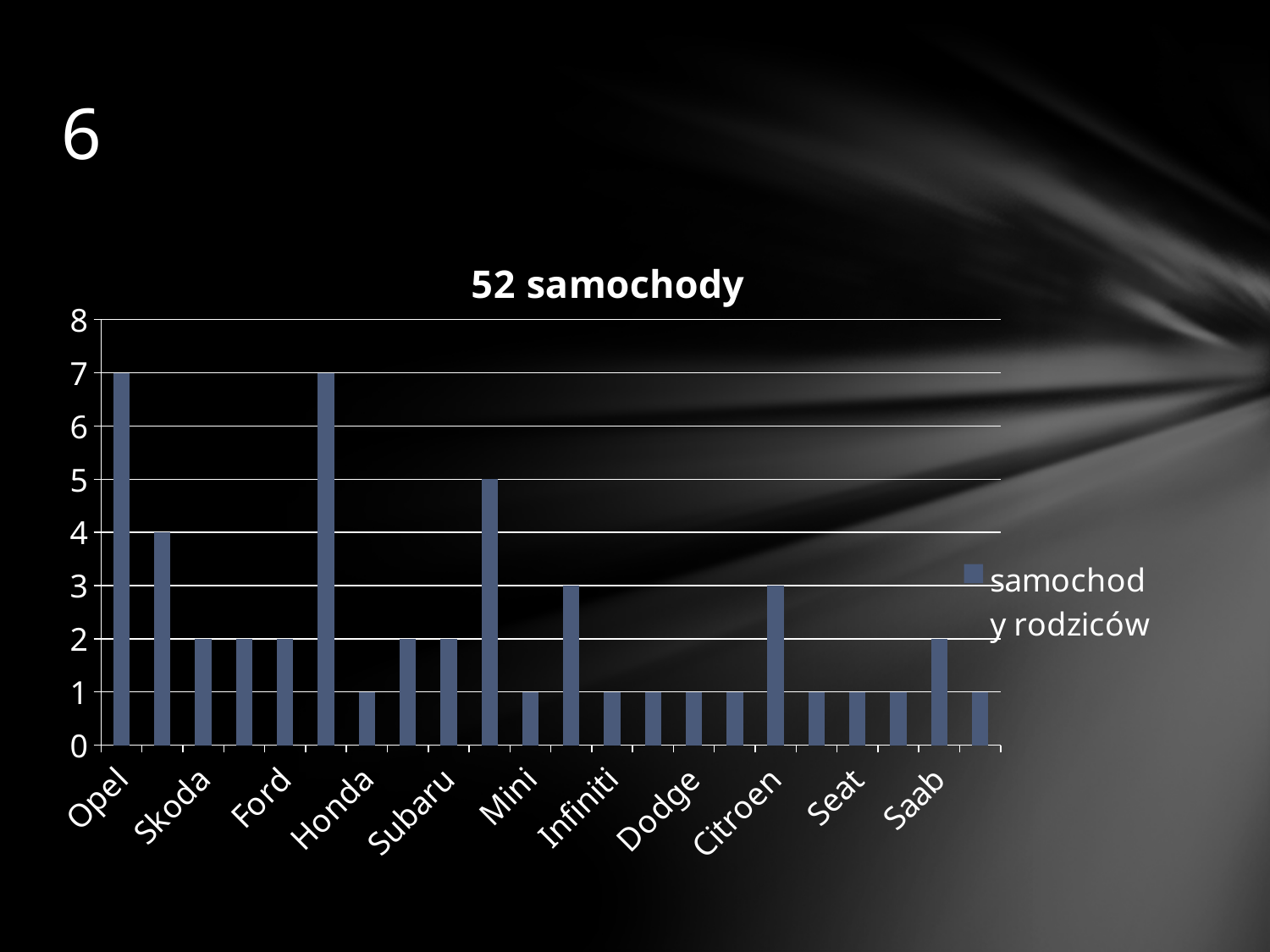
Which has a larger value, Citroen or Seat? Citroen How many bars are plotted in the chart? 22 What is the value for Opel? 7 What is the difference between the values for Opel and Citroen? 4 Is the value for Opel greater or less than 5? greater How many series does the legend list? 1 What is the value for Skoda? 2 Which has a larger value, Opel or Skoda? Opel What is the value for Honda? 1 What is the title of the chart? 52 samochody What is the value for Saab? 2 What is the value for Citroen? 3